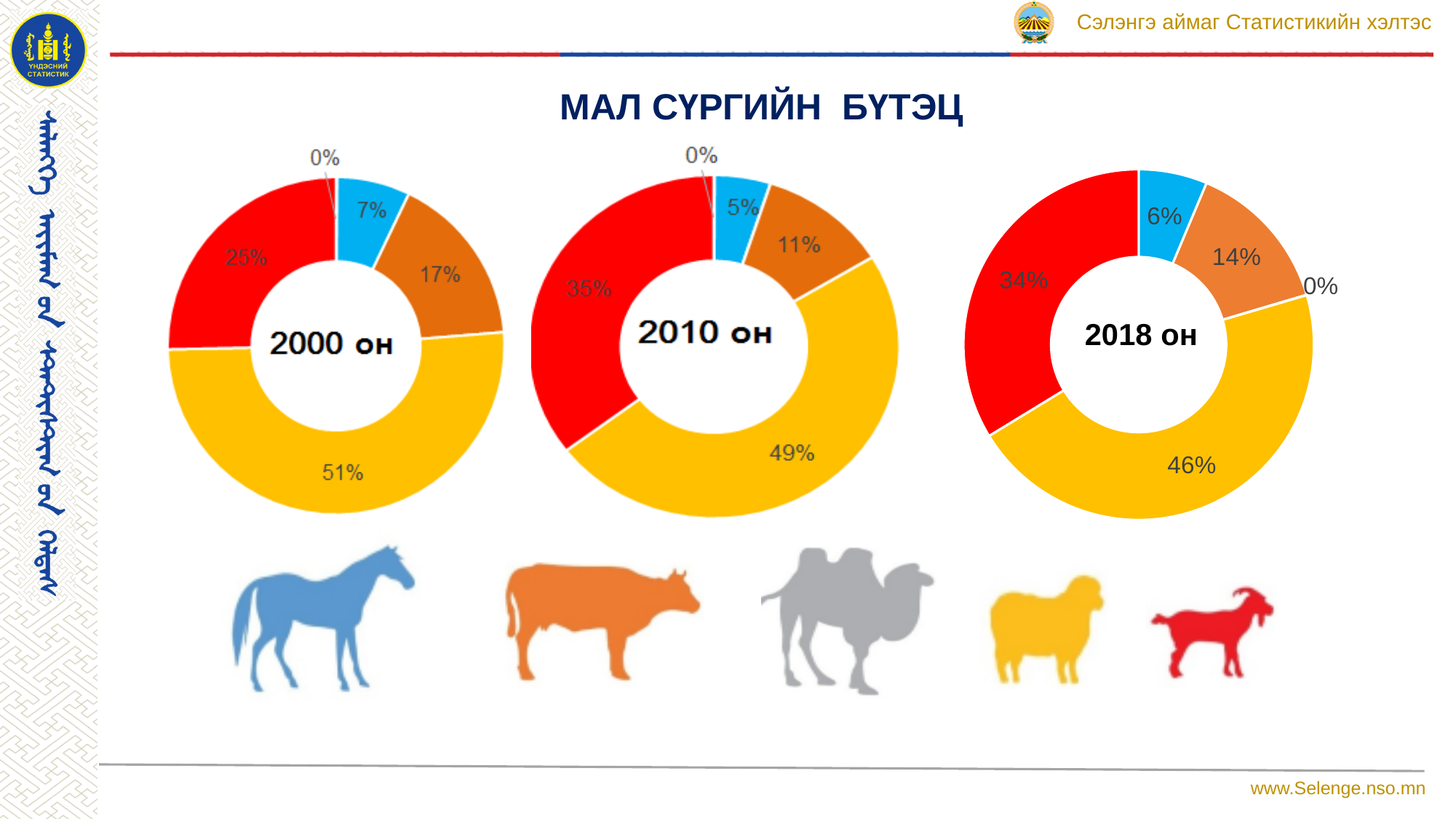
In the '2018 он' chart, which slice is the largest? The yellow (sheep) slice, 46% How does the red (goat) share change from the '2000 он' chart to the '2010 он' chart? It rises from 25% to 35% In the '2018 он' chart, what is the difference between the yellow (sheep) share and the red (goat) share? 12 percentage points In the '2018 он' chart, what share does the blue (horse) slice have? 6% In the '2010 он' chart, what share does the orange (cattle) slice have? 11% How many donut charts are on the slide? 3 What kind of charts are shown on the slide? Donut (pie) charts In the '2000 он' chart, what share does the red (goat) slice have? 25% Which is larger in the '2010 он' chart: the red (goat) share or the orange (cattle) share? The red (goat) share, 35% In the '2010 он' chart, which slice is the smallest? The grey (camel) slice, 0% What is the title of the slide above the charts? МАЛ СҮРГИЙН БҮТЭЦ In the '2000 он' chart, what share does the yellow (sheep) slice have? 51%